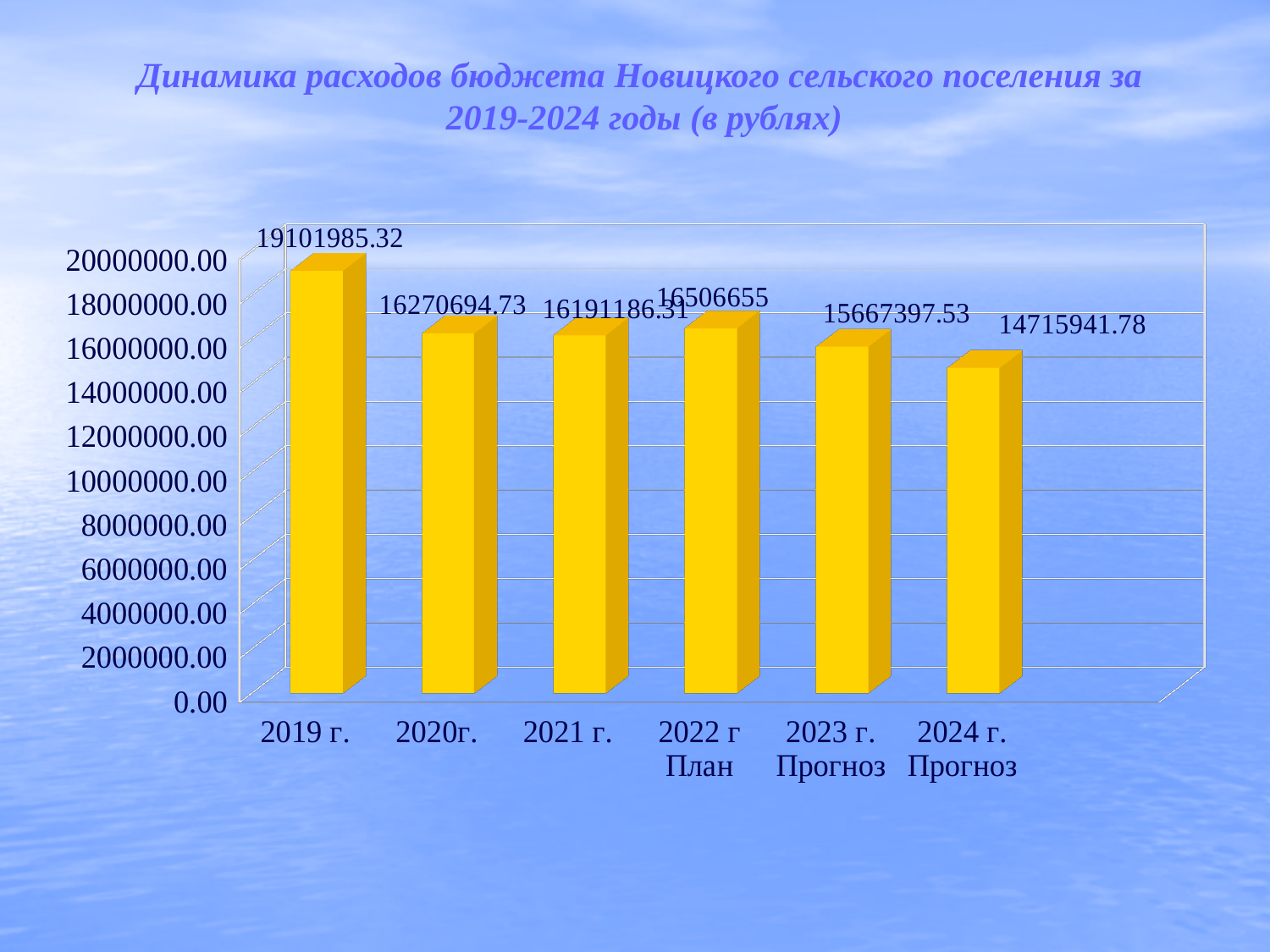
What is the value shown for 2024 г. Прогноз? 14715941.78 How many years (categories) are shown on the chart? 6 What type of chart is shown on the slide? bar chart What is the difference between the values for 2019 г. and 2024 г. Прогноз? 4386043.54 Which year has the lowest budget expenditure? 2024 г. Прогноз What is the value shown for 2023 г. Прогноз? 15667397.53 Which year has the highest budget expenditure? 2019 г. Is the value for 2024 г. Прогноз greater or less than 16000000.00? less What is the value shown for 2022 г План? 16506655 What is the budget expenditure value for 2019 г.? 19101985.32 Which is larger, the value for 2022 г План or the value for 2023 г. Прогноз? 2022 г План What is the difference between the values for 2022 г План and 2023 г. Прогноз? 839257.47